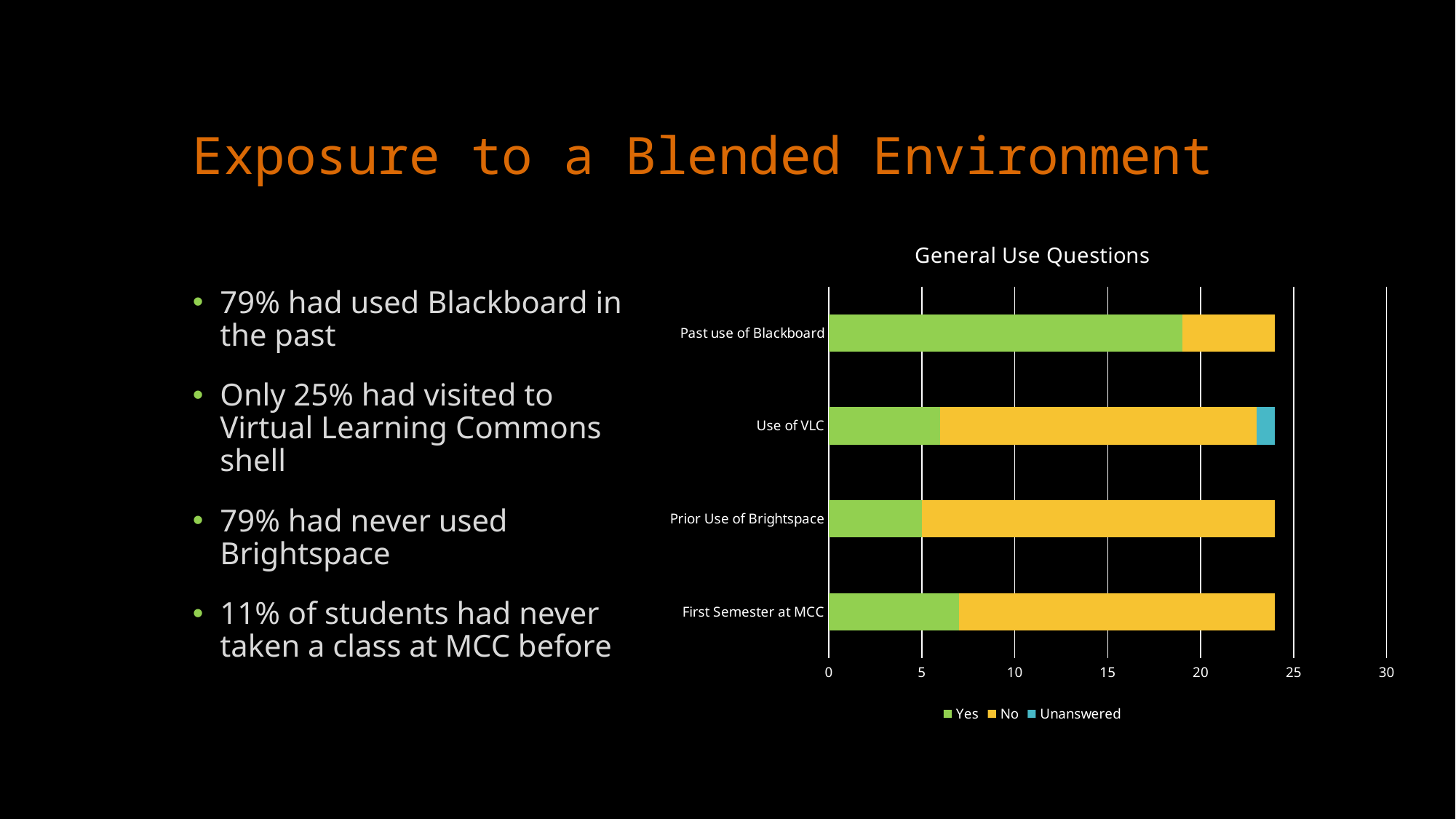
Is the No value for Prior Use of Brightspace greater or less than 15? greater How many series does the legend list? 3 Is the Yes value for Past use of Blackboard greater or less than 15? greater What type of chart is shown on the slide? bar chart Which category has the lowest No value? Past use of Blackboard For Past use of Blackboard, which is larger, the Yes value or the No value? Yes Which category has the highest Yes value? Past use of Blackboard How many categories are shown on the chart? 4 For First Semester at MCC, which is larger, the Yes value or the No value? No Is the Yes value for Use of VLC greater or less than 10? less What is the title of the chart? General Use Questions Which category has an Unanswered segment? Use of VLC